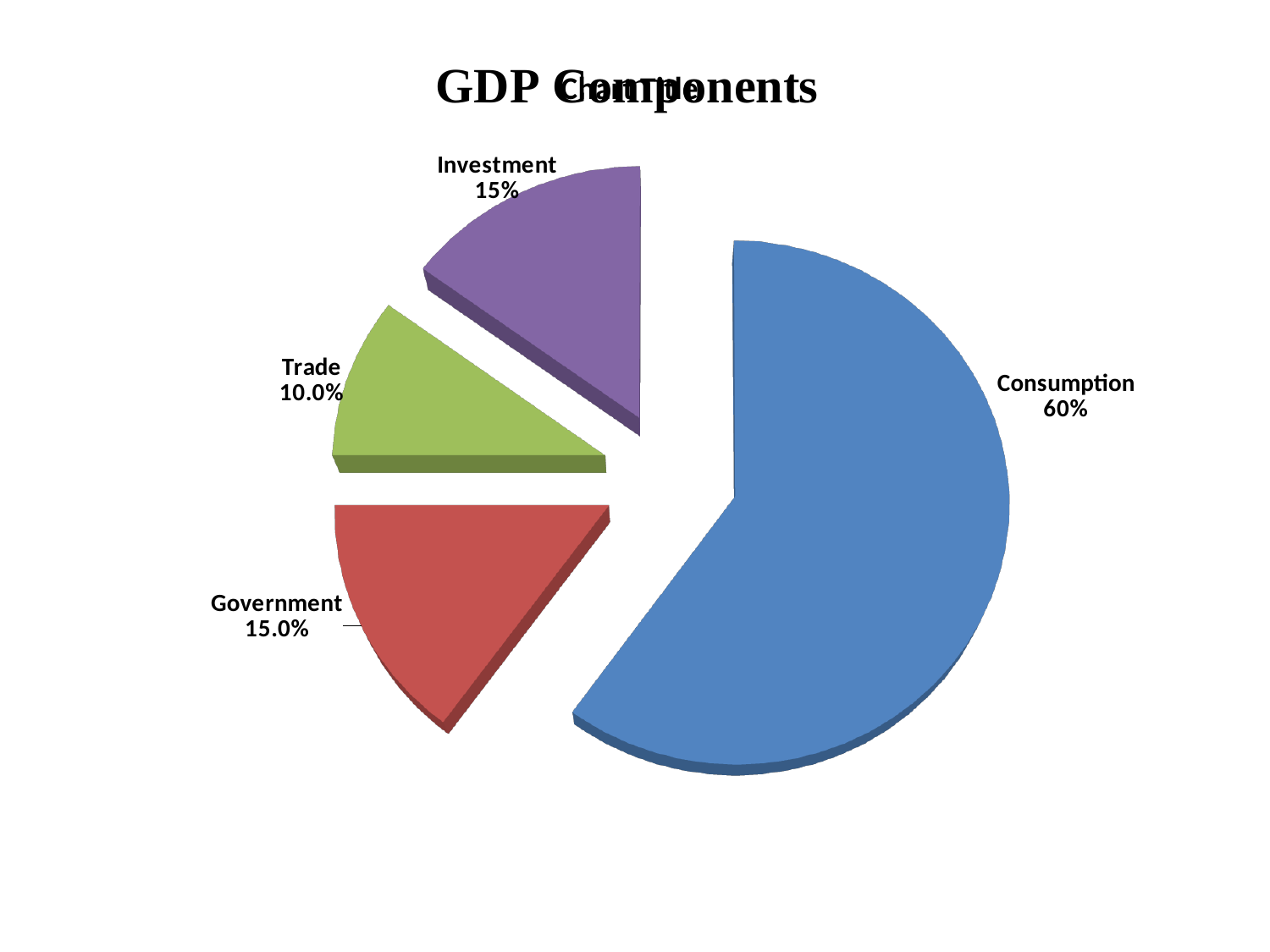
Which component has the smallest slice of the pie? Trade By how many percentage points does Government exceed Trade? 5 Which is larger, the Consumption slice or the Investment slice? Consumption Which component has the largest slice of the pie? Consumption What kind of chart is shown on the slide? pie chart By how many percentage points does Consumption exceed Trade? 50 What is the value shown for Government? 15.0% How many slices does the pie chart have? 4 What share of the pie does Consumption have? 60% What colour is the Consumption slice? blue What is the value shown for Investment? 15% What is the value shown for Trade? 10.0%